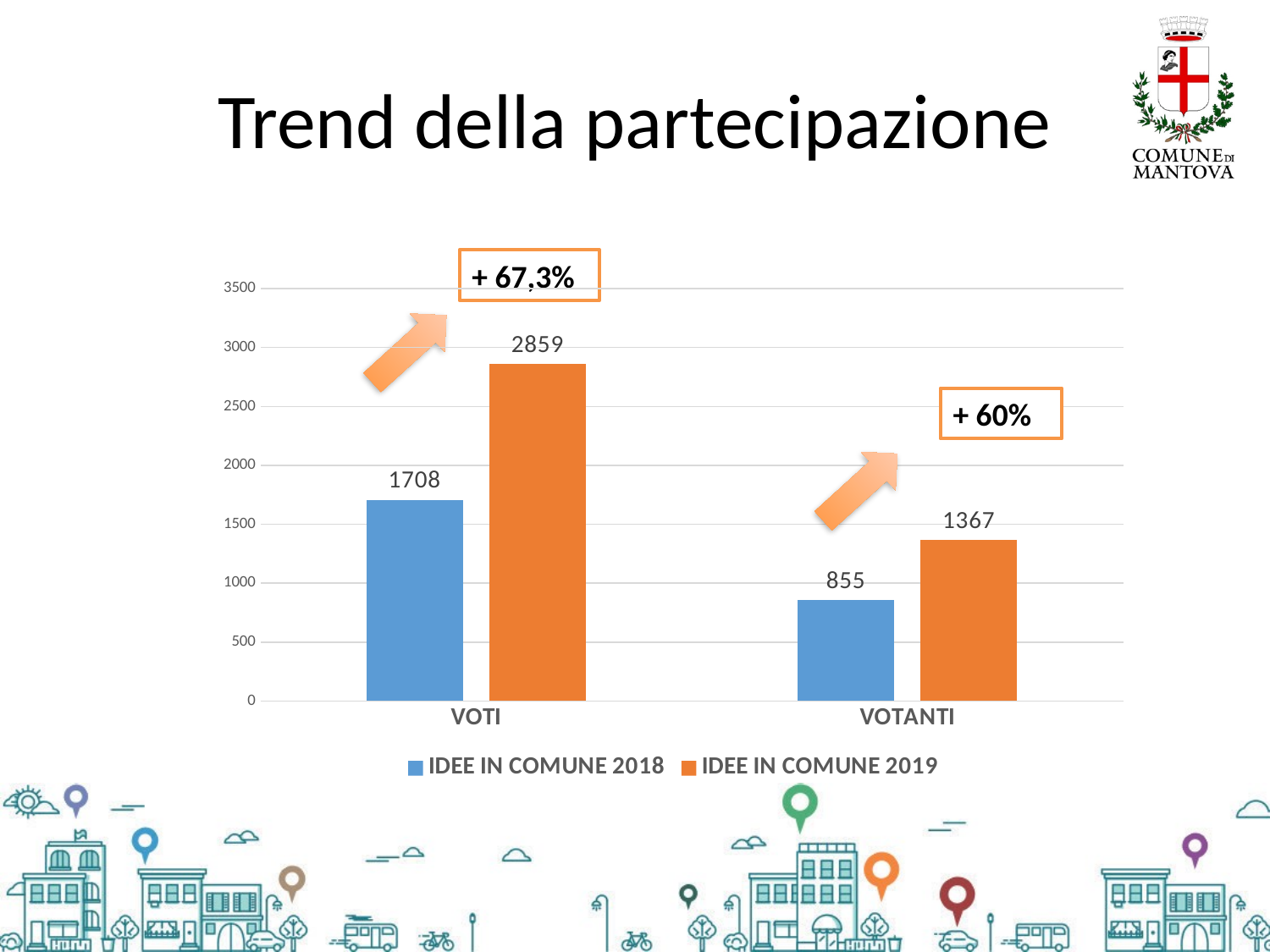
What is the value for VOTI in the IDEE IN COMUNE 2019 series? 2859 Which is larger: VOTANTI in 2019 or VOTI in 2018? VOTI in 2018 Which bar has the lowest value on the chart? VOTANTI, IDEE IN COMUNE 2018 What kind of chart is shown on the slide? Bar chart What is the difference between the 2019 and 2018 values for VOTANTI? 512 How many series does the legend list? 2 What is the value for VOTI in the IDEE IN COMUNE 2018 series? 1708 What is the value for VOTANTI in the IDEE IN COMUNE 2019 series? 1367 What is the value for VOTANTI in the IDEE IN COMUNE 2018 series? 855 Which bar has the highest value on the chart? VOTI, IDEE IN COMUNE 2019 What is the difference between the 2019 and 2018 values for VOTI? 1151 What percentage increase is annotated above the VOTI bars? + 67,3%